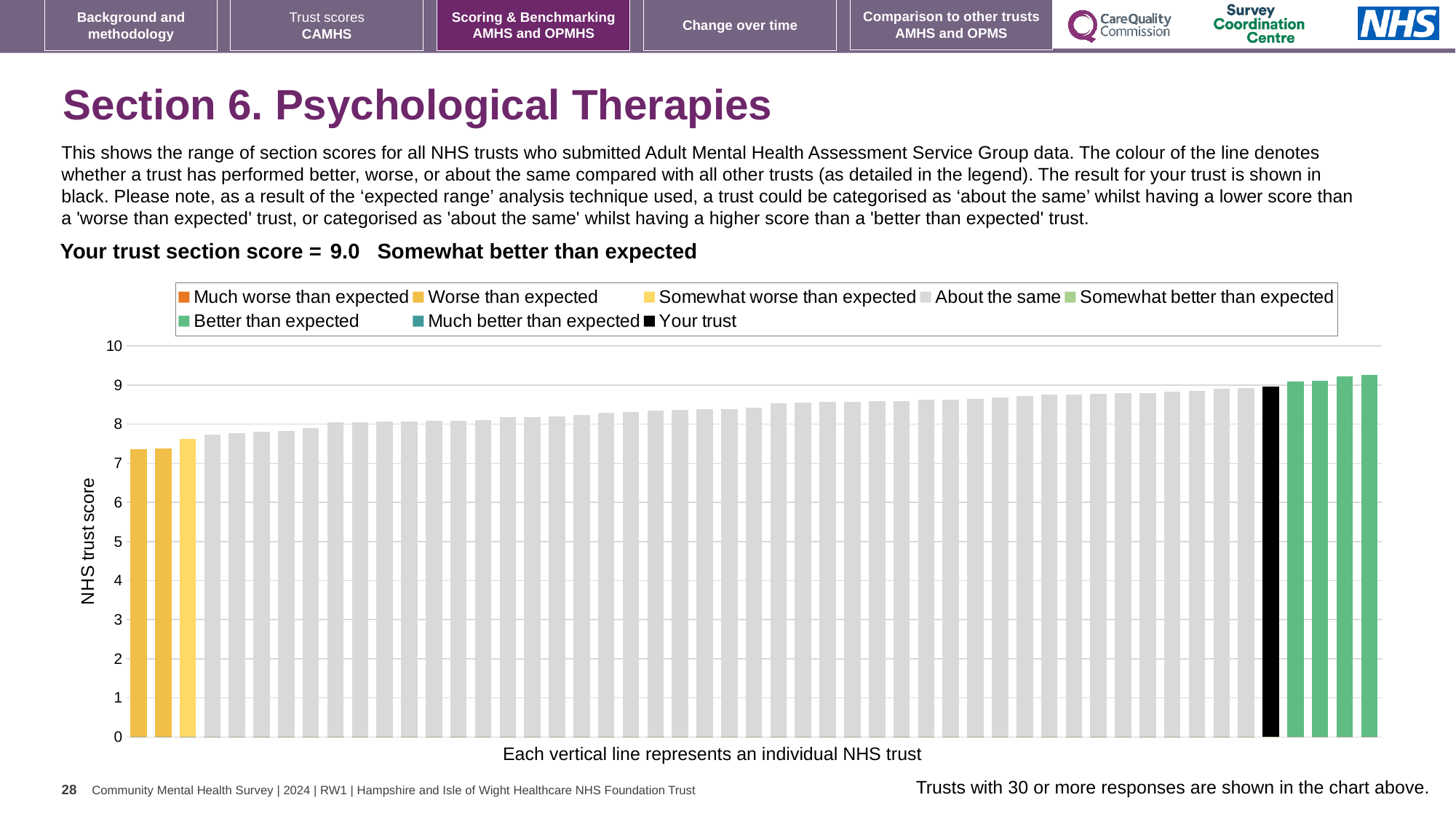
Is the value of the black 'Your trust' bar greater or less than 8? greater What kind of chart is shown on the slide? bar chart How many entries does the chart legend list? 8 How many green bars appear to the right of the black 'Your trust' bar? 4 What is the label on the y axis of the chart? NHS trust score What is your trust's section score for Psychological Therapies, as printed on the slide? 9.0 Do the bar values rise or fall moving from left to right along the x axis? rise Is the value of the leftmost (lowest) bar greater or less than 8? less How many yellow bars appear at the left end of the chart? 3 What colour is the bar representing your trust, according to the legend? black Is the value of the rightmost (highest) bar greater or less than 9? greater